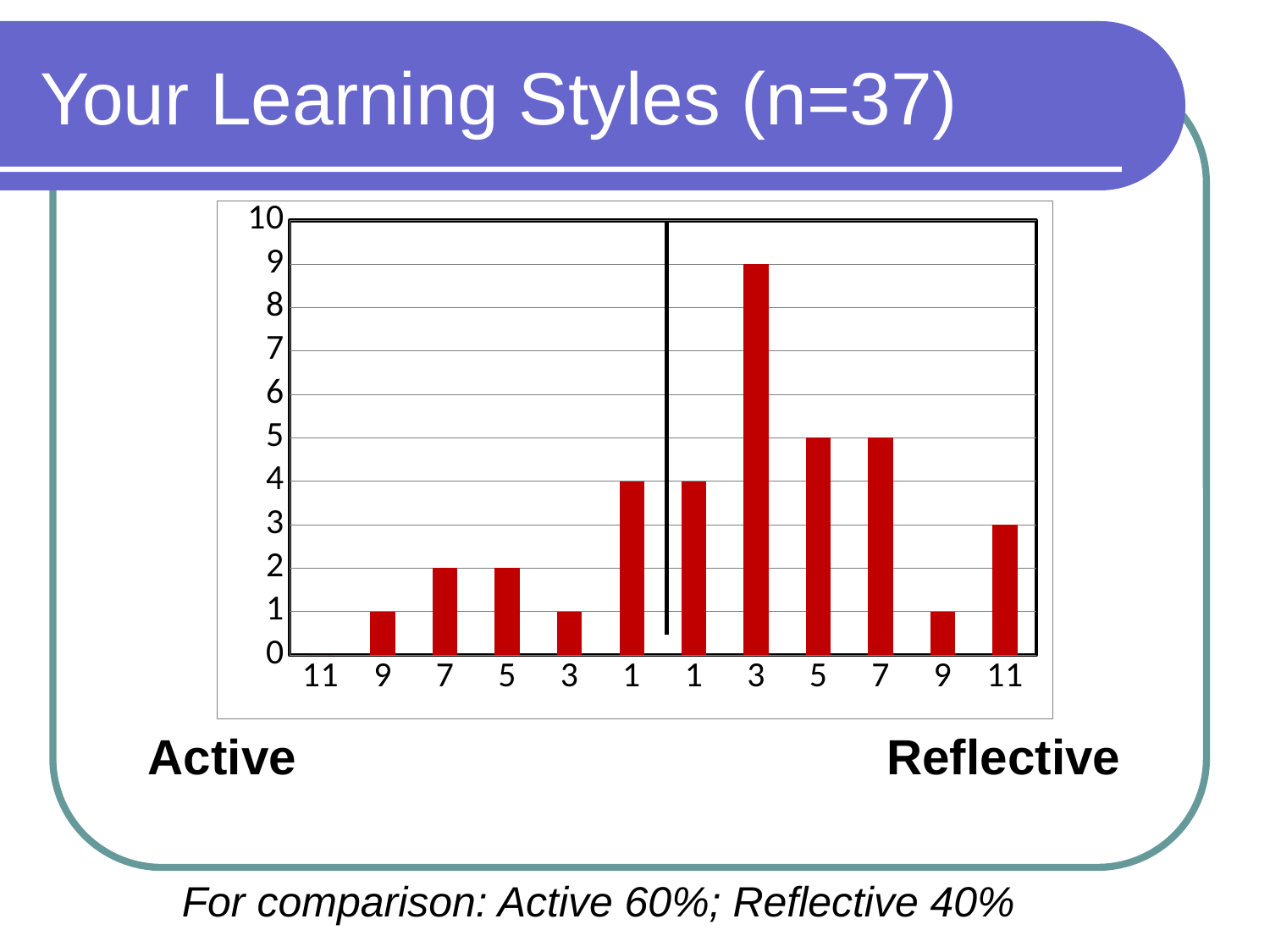
Which is larger: the bar labelled 7 on the Active side or the bar labelled 7 on the Reflective side? 7 on the Reflective side Which category has the tallest bar in the chart? 3 on the Reflective side How many categories are shown along the x axis of the chart? 12 What is the title of the slide containing the chart? Your Learning Styles (n=37) What is the value of the bar labelled 3 on the Reflective side of the chart? 9 What colour are the bars in the chart? red Is the value of the bar labelled 3 on the Reflective side greater or less than 5? greater What kind of chart is shown on the slide? bar chart What is the value of the bar labelled 11 on the Reflective side of the chart? 3 What is the value of the bar labelled 1 on the Active side of the chart? 4 What is the difference between the bar labelled 3 on the Reflective side and the bar labelled 5 on the Reflective side? 4 What is the value of the bar labelled 9 on the Active side of the chart? 1